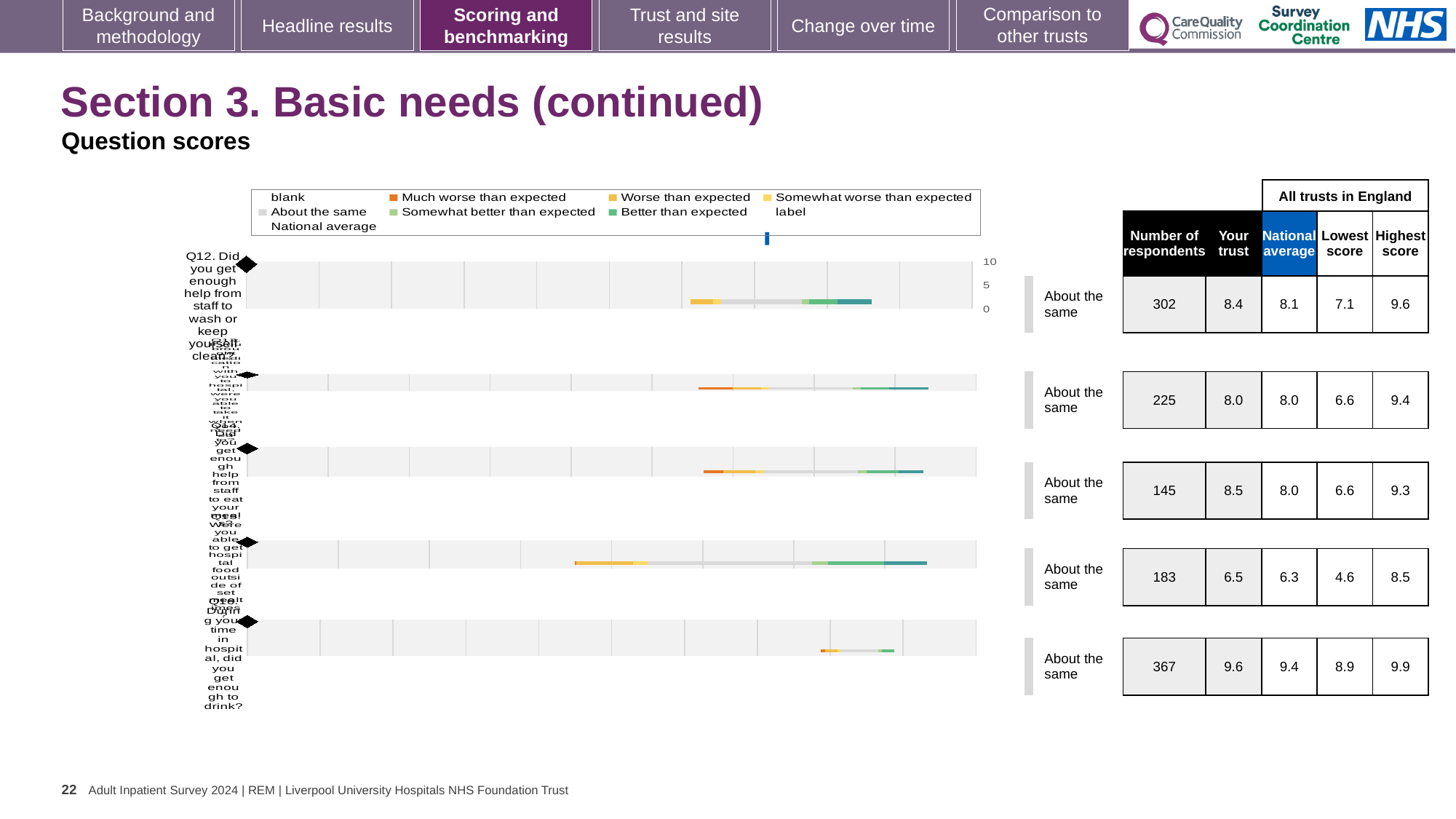
What is the national average score for Q12 (the first row) in the table beside the chart? 8.1 What benchmark category is shown next to every question row on the chart? About the same What kind of chart is used to show the question scores on this slide? bar chart Which row has the highest 'Your trust' score in the table beside the chart? The fifth (bottom) row, 9.6 How many question rows are plotted in the chart? 5 For Q12 (the first row), how much higher is the 'Your trust' score than the national average? 0.3 What is the highest score across all trusts in England for the fourth row? 8.5 What is the 'Your trust' score for Q12 (the first row) in the table beside the chart? 8.4 How many respondents are listed for the fifth (bottom) row in the table beside the chart? 367 In the table beside the chart, how many respondents are listed for Q12 (the first row)? 302 For the fourth row, which is larger: the 'Your trust' score or the national average? Your trust (6.5 vs 6.3) Which row has the lowest 'Your trust' score in the table beside the chart? The fourth row, 6.5